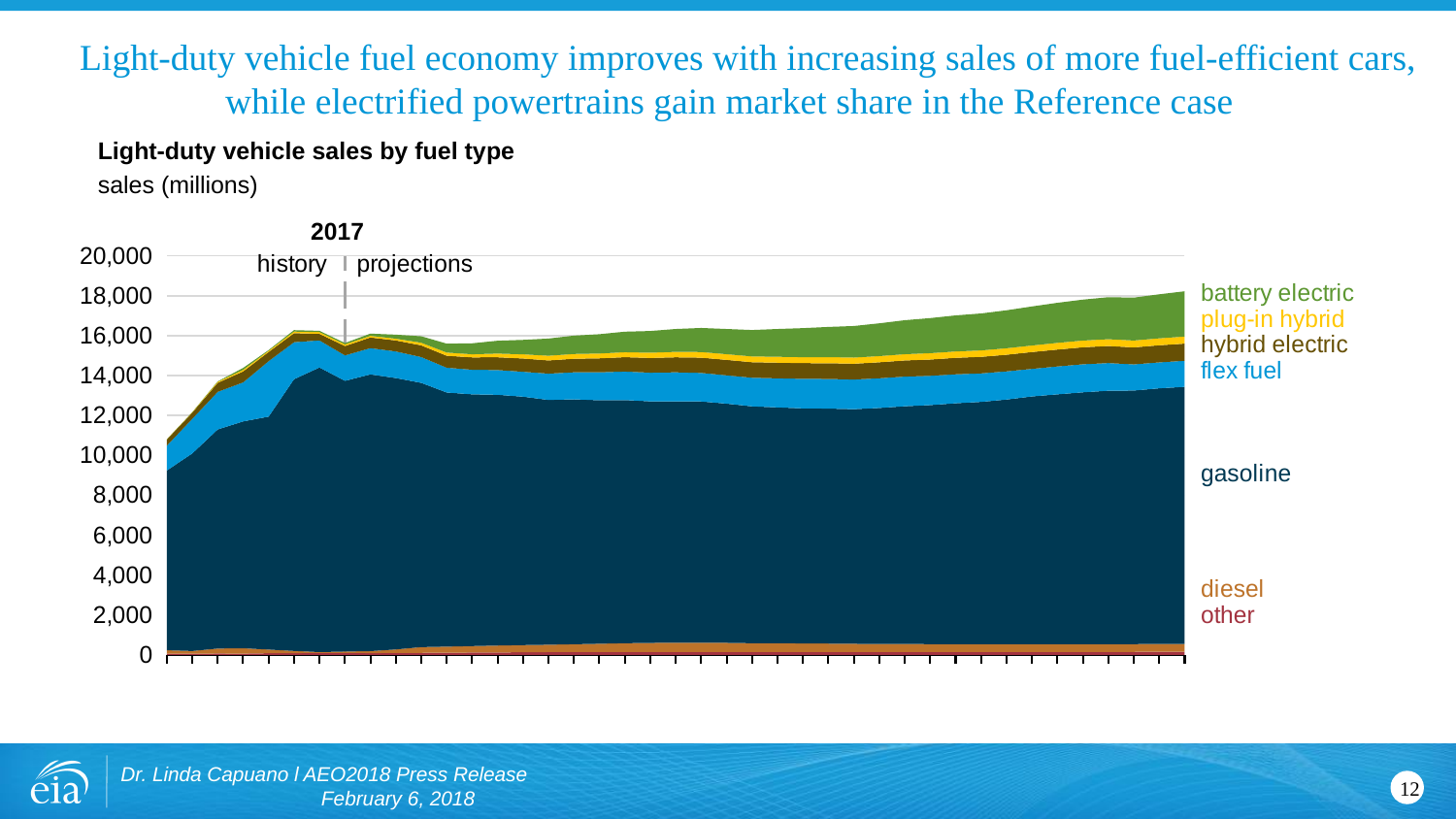
Is the total of all light-duty vehicle sales at the start of the history period greater or less than 12,000? less Which year separates history from projections on the chart? 2017 Are gasoline vehicle sales in the final projection year greater or less than 12,000? greater Is the total of all light-duty vehicle sales in the final projection year greater or less than 16,000? greater In what units are sales shown on the y axis? sales (millions) How many fuel-type series are labelled on the chart? 7 Which fuel type accounts for the largest share of light-duty vehicle sales throughout the chart? gasoline Do total light-duty vehicle sales rise or fall over the projection period after 2017? rise What kind of chart is shown on the slide? stacked area chart What is the title of the chart? Light-duty vehicle sales by fuel type Which series is plotted at the top of the stack, above plug-in hybrid? battery electric